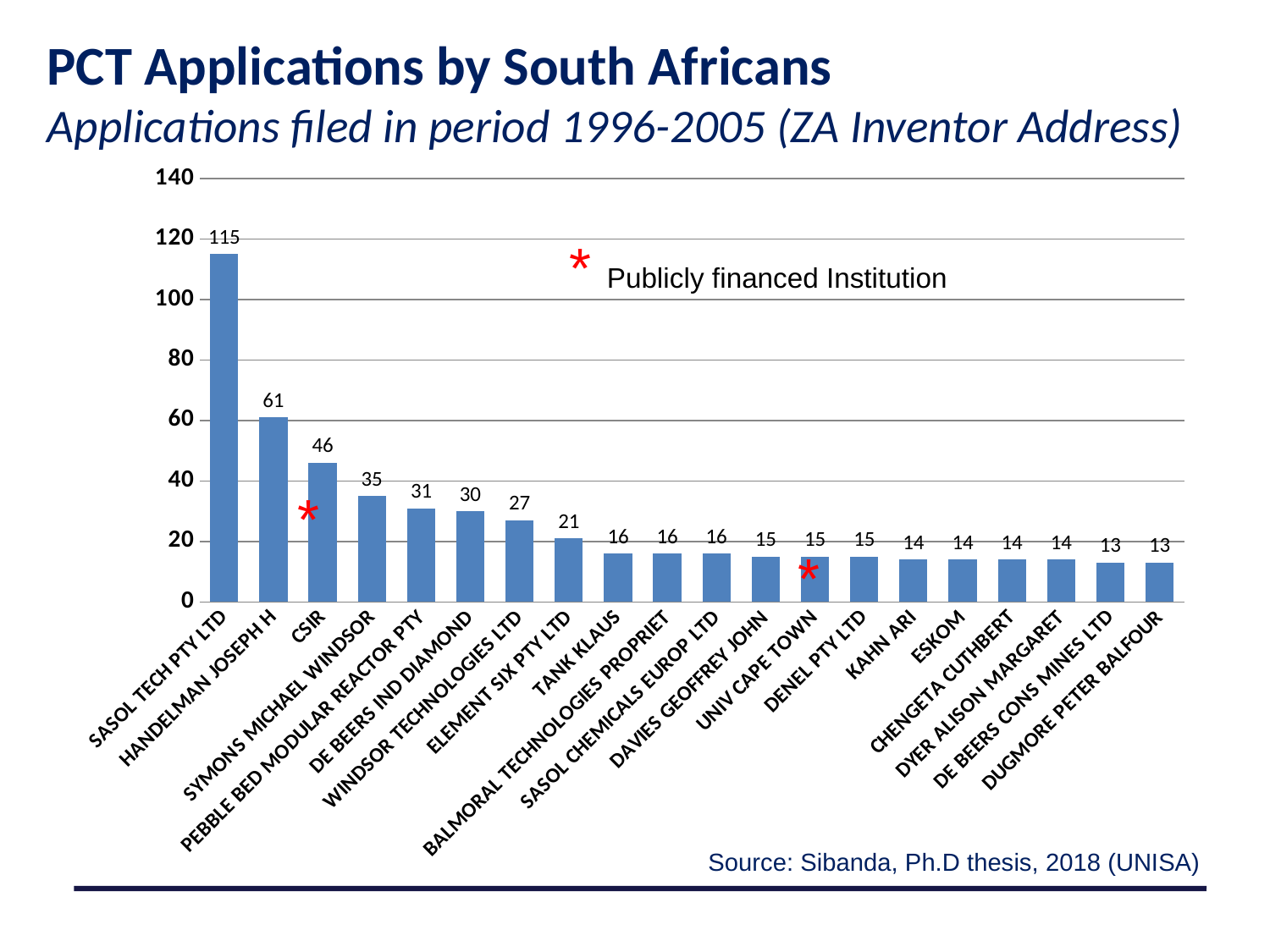
What is the value for CSIR? 46 Which applicant has the highest number of PCT applications? SASOL TECH PTY LTD How many PCT applications are shown for SASOL TECH PTY LTD? 115 What kind of chart is shown on the slide? bar chart What is the difference between the values for CSIR and SYMONS MICHAEL WINDSOR? 11 Which is larger, the value for DE BEERS IND DIAMOND or the value for WINDSOR TECHNOLOGIES LTD? DE BEERS IND DIAMOND What is the value for ESKOM? 14 Is the value for HANDELMAN JOSEPH H greater or less than 80? less What is the value for UNIV CAPE TOWN? 15 What does the red asterisk on the chart indicate? Publicly financed Institution How many applicants are shown on the chart? 20 What is the difference between the values for SASOL TECH PTY LTD and HANDELMAN JOSEPH H? 54